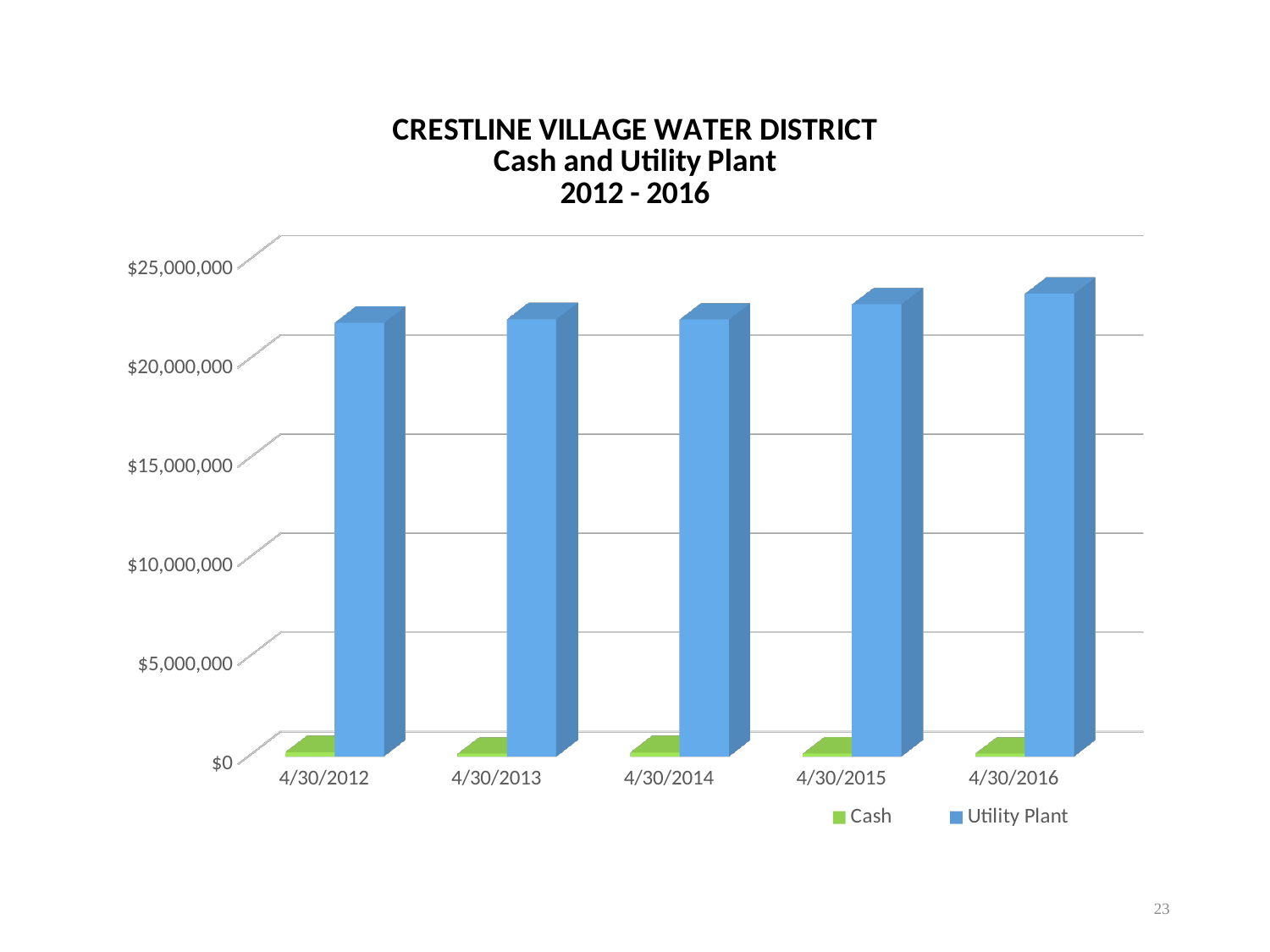
What years does the chart title say it covers? 2012 - 2016 Which is larger, the Utility Plant value for 4/30/2016 or for 4/30/2013? 4/30/2016 Which is larger on 4/30/2015, Cash or Utility Plant? Utility Plant What kind of chart is shown on the slide? Bar chart How many dates are shown along the x axis? 5 Is the Cash value for 4/30/2014 greater or less than $5,000,000? less Is the Utility Plant value for 4/30/2016 greater or less than $25,000,000? less On which date is the Utility Plant value highest? 4/30/2016 Is the Utility Plant value for 4/30/2012 greater or less than $20,000,000? greater How many series does the legend list? 2 What colour represents the Cash series? Green Does the Utility Plant value rise or fall from 4/30/2012 to 4/30/2016? Rise